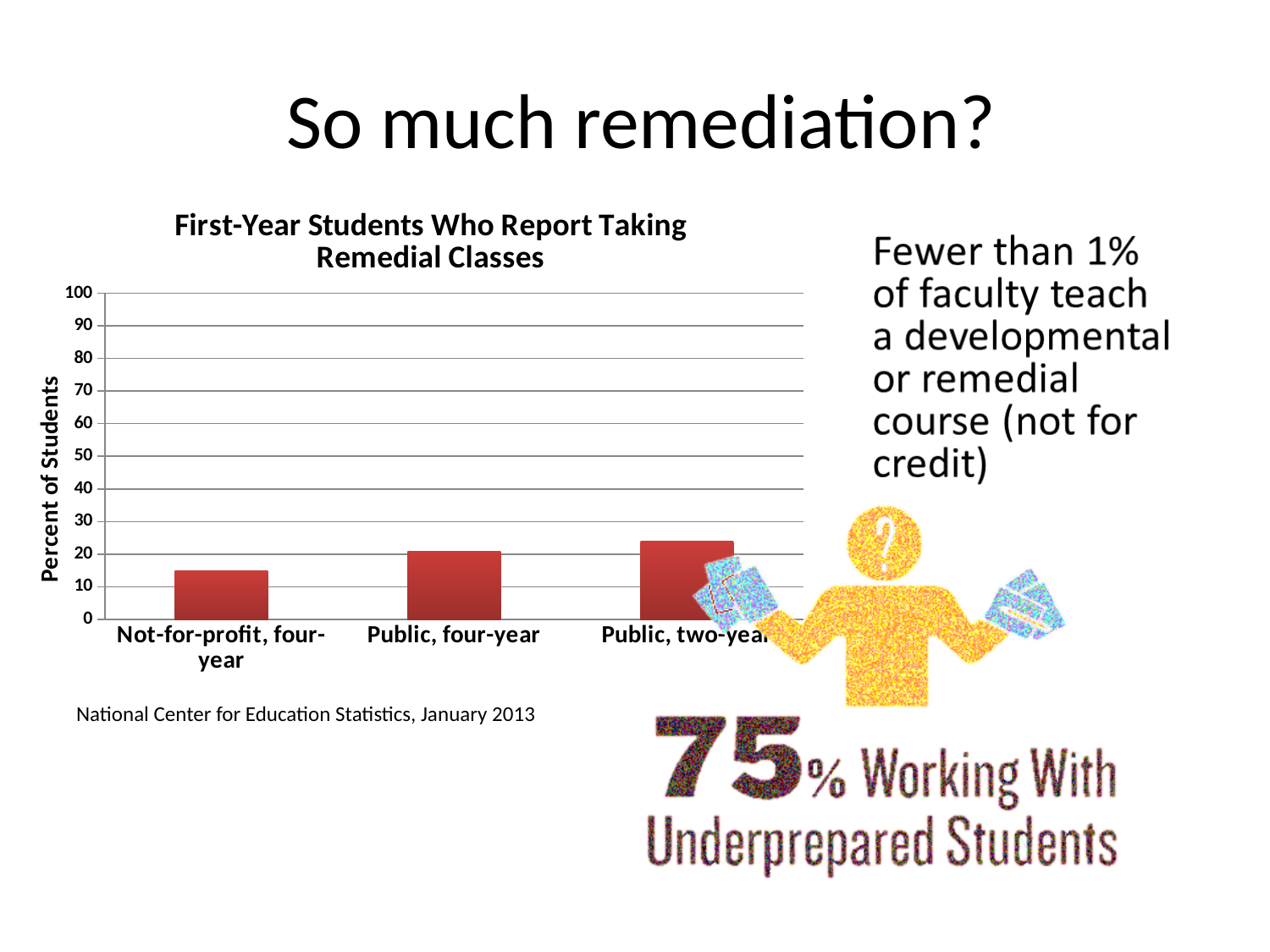
Is the value for Public, four-year greater or less than 30? less How many categories are shown in the chart? 3 What kind of chart is shown on the slide? Bar chart What is the title of the chart? First-Year Students Who Report Taking Remedial Classes Which category has the lowest percentage of first-year students reporting remedial classes? Not-for-profit, four-year Is the value for Not-for-profit, four-year greater or less than 20? less Is the value for Public, two-year greater or less than 30? less What is the label on the vertical axis of the chart? Percent of Students Which category has the highest percentage of first-year students reporting remedial classes? Public, two-year Which is larger, the value for Not-for-profit, four-year or the value for Public, two-year? Public, two-year